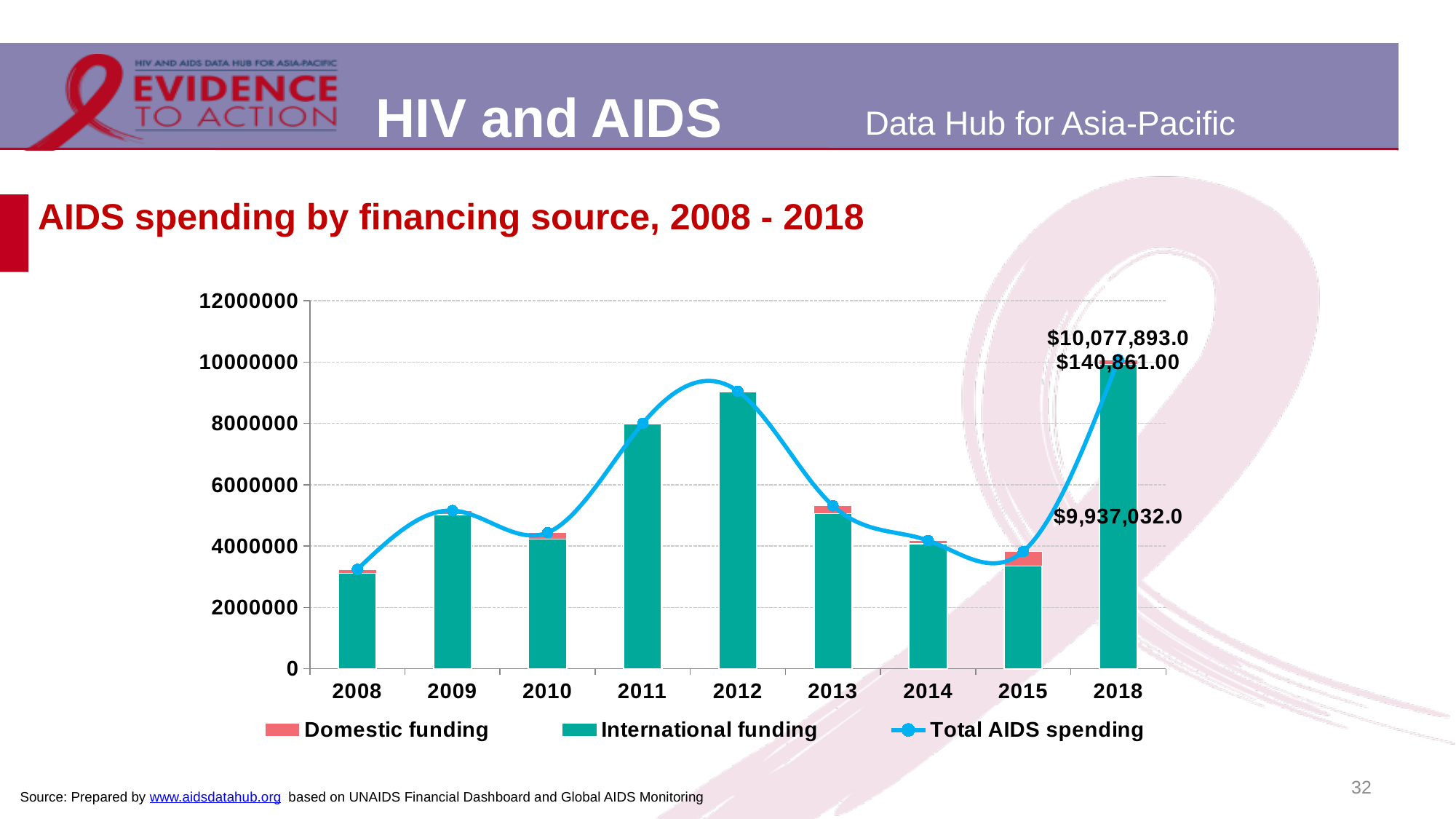
Which year has the lowest Total AIDS spending? 2008 Which year has higher Total AIDS spending, 2009 or 2011? 2011 How many series does the legend list? 3 What is the Total AIDS spending value labelled for 2018? $10,077,893.0 Which year has the highest Total AIDS spending? 2018 What is the International funding value labelled for 2018? $9,937,032.0 Does Total AIDS spending rise or fall from 2012 to 2015? fall What is the title of the chart? AIDS spending by financing source, 2008 - 2018 Is the Total AIDS spending for 2010 greater or less than 6000000? less How many years are shown on the x axis? 9 Is the Total AIDS spending for 2012 greater or less than 8000000? greater What is the Domestic funding value labelled for 2018? $140,861.00